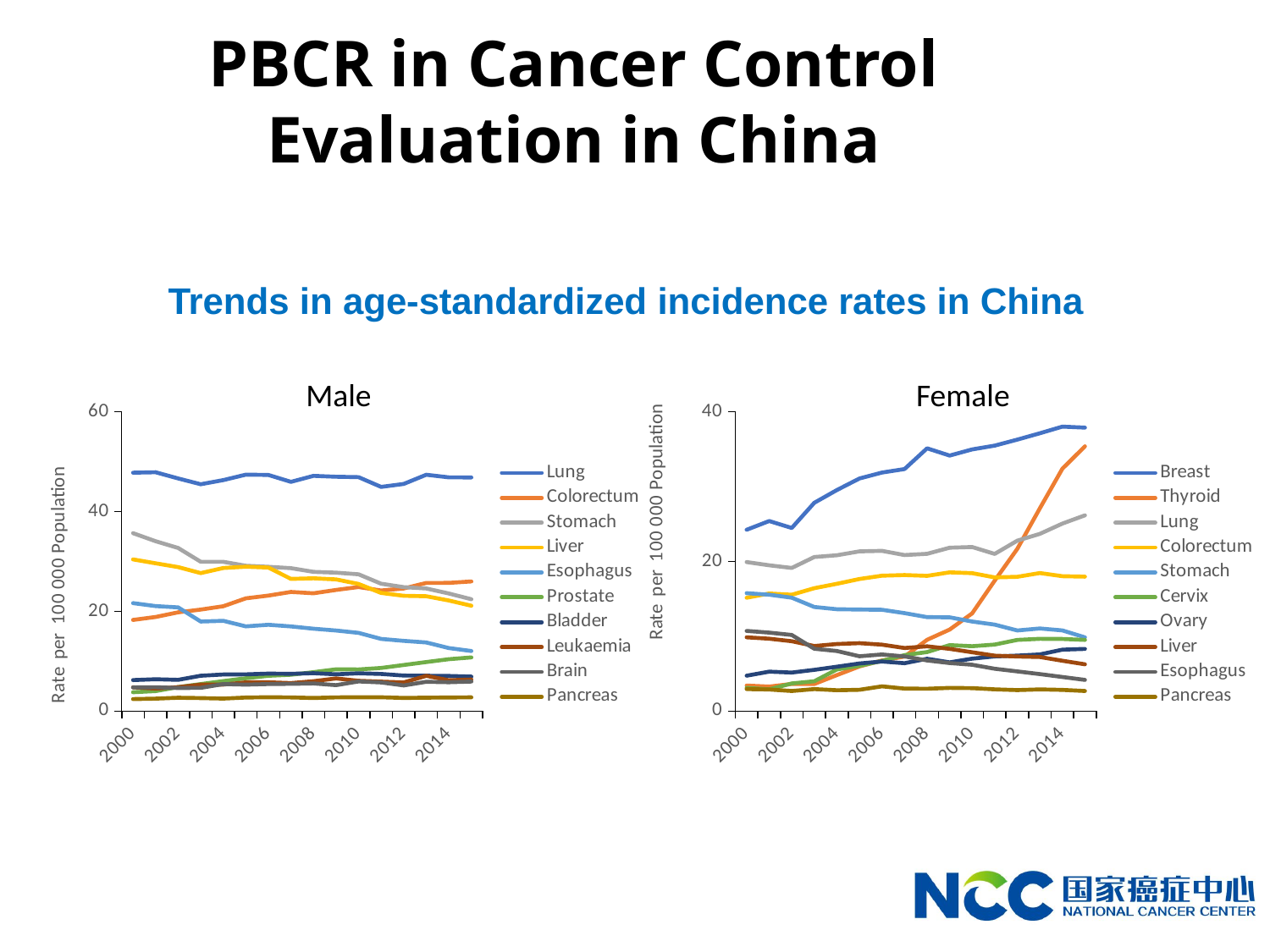
In the Male chart, which cancer site has the lowest incidence rate across the whole period? Pancreas What is the y-axis label of the Female chart? Rate per 100 000 Population In the Female chart, which is larger in 2015, the Breast rate or the Lung rate? Breast How many series does the legend of the Male chart list? 10 In the Female chart, does the Thyroid incidence rate rise or fall from 2000 to 2015? rise In the Female chart, which cancer site has the highest incidence rate in 2015? Breast In the Female chart, is the Thyroid rate in 2000 greater or less than 10? less How many series does the legend of the Female chart list? 10 In the Male chart, does the Stomach incidence rate rise or fall from 2000 to 2015? fall In the Male chart, is the Lung rate in 2000 greater or less than 40? greater In the Male chart, which cancer site has the highest incidence rate across the whole period? Lung What kind of chart is the Male chart? line chart